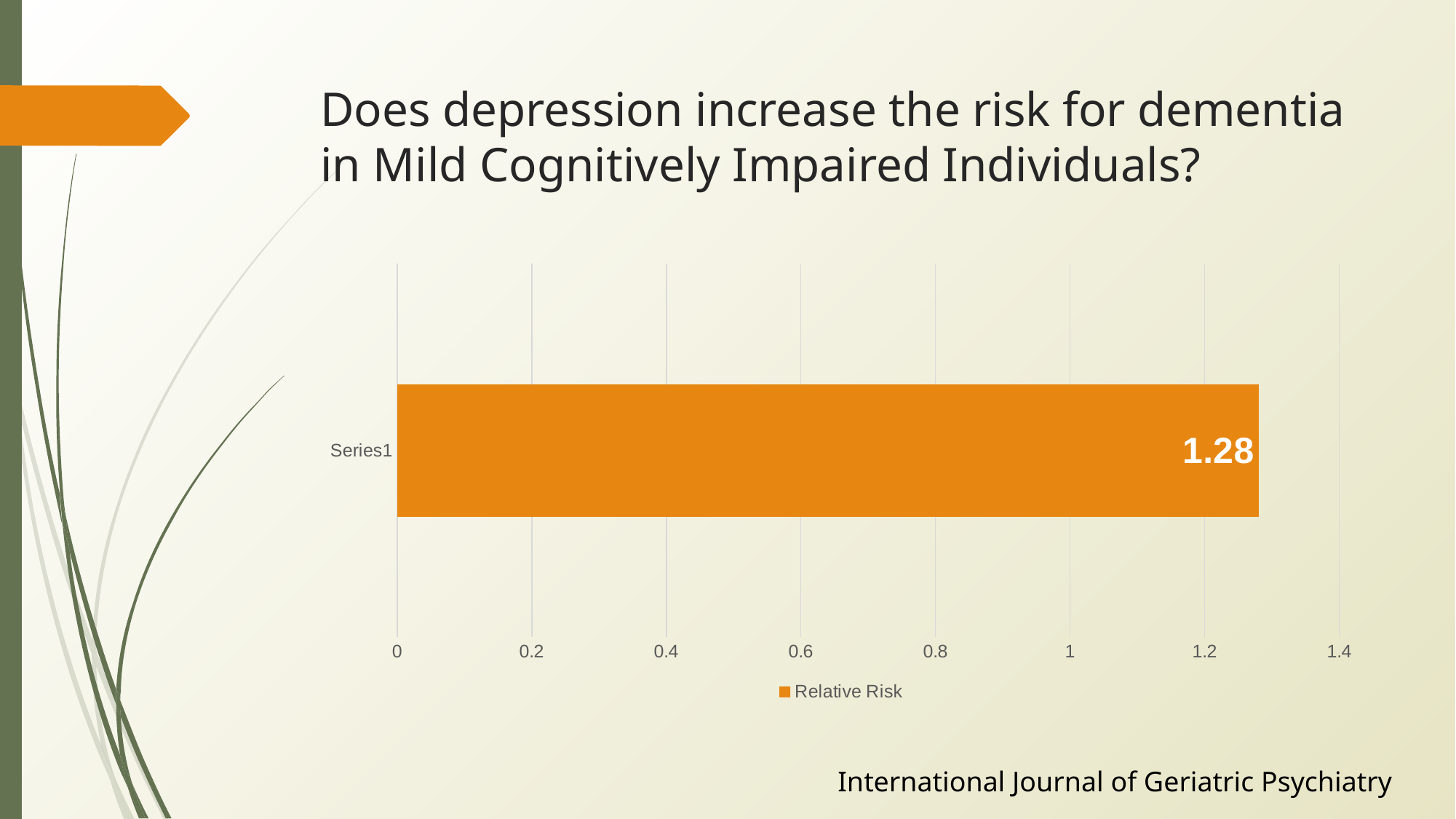
What is the name of the series shown in the legend? Relative Risk Is the value for Series1 greater or less than 1? greater What is the value of the Relative Risk bar for Series1? 1.28 How many bars are plotted in the chart? 1 What is the maximum value shown on the x axis? 1.4 Is the value for Series1 greater or less than 1.4? less How many series does the legend list? 1 What is the category label on the y axis? Series1 What kind of chart is shown on the slide? bar chart